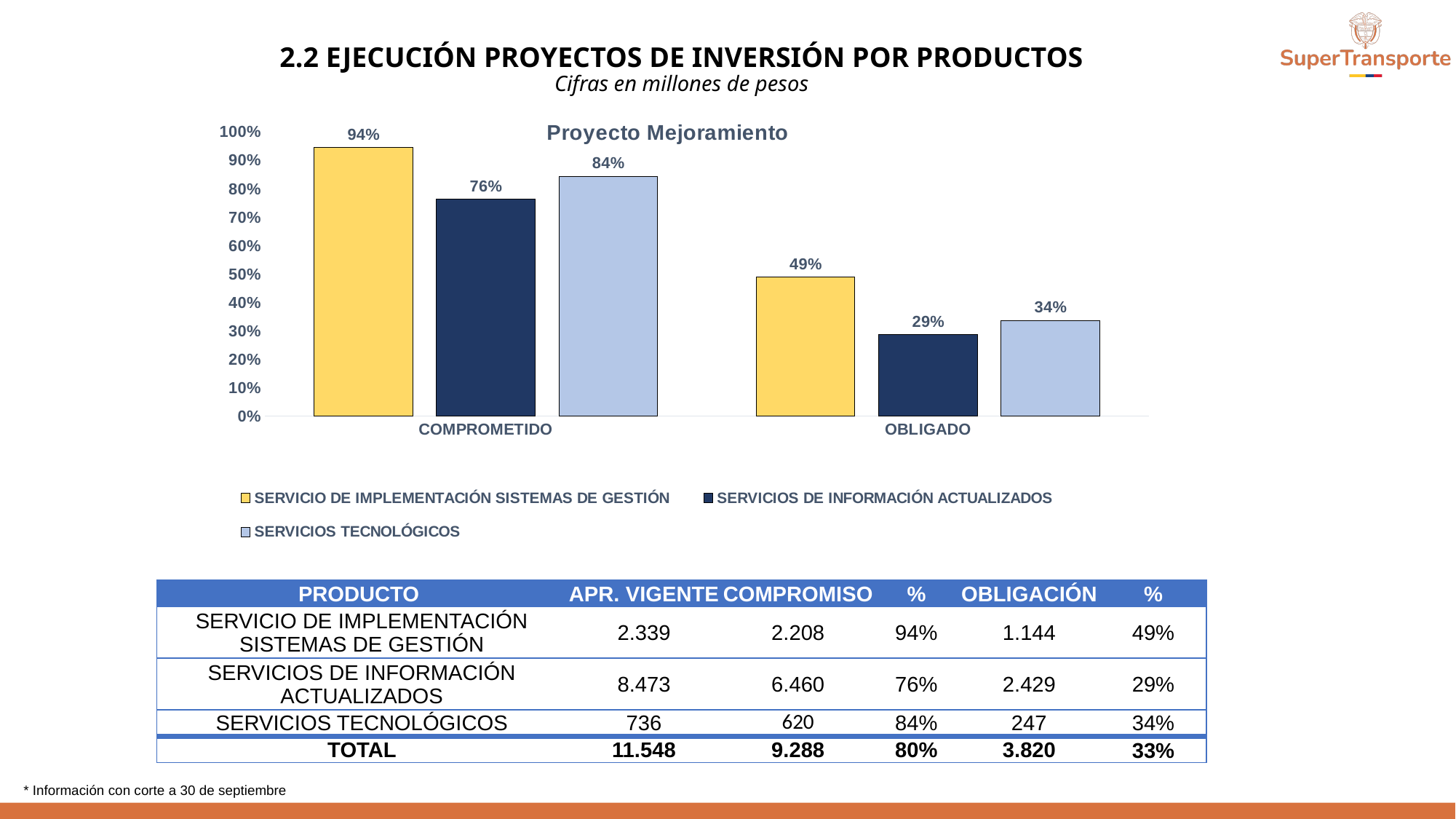
How many category groups are shown on the x axis? 2 What kind of chart is shown on the slide? bar chart What is the value for SERVICIO DE IMPLEMENTACIÓN SISTEMAS DE GESTIÓN in the COMPROMETIDO group? 94% What is the title of the chart? Proyecto Mejoramiento Which series has the highest value in the OBLIGADO group? SERVICIO DE IMPLEMENTACIÓN SISTEMAS DE GESTIÓN What is the value for SERVICIOS DE INFORMACIÓN ACTUALIZADOS in the OBLIGADO group? 29% How many series does the legend list? 3 Is the OBLIGADO value for SERVICIO DE IMPLEMENTACIÓN SISTEMAS DE GESTIÓN greater or less than 40%? greater Which is larger: the OBLIGADO value for SERVICIOS TECNOLÓGICOS or for SERVICIOS DE INFORMACIÓN ACTUALIZADOS? SERVICIOS TECNOLÓGICOS Which series has the lowest value in the COMPROMETIDO group? SERVICIOS DE INFORMACIÓN ACTUALIZADOS What is the difference between the COMPROMETIDO and OBLIGADO values for SERVICIOS TECNOLÓGICOS? 50% What is the value for SERVICIOS TECNOLÓGICOS in the COMPROMETIDO group? 84%